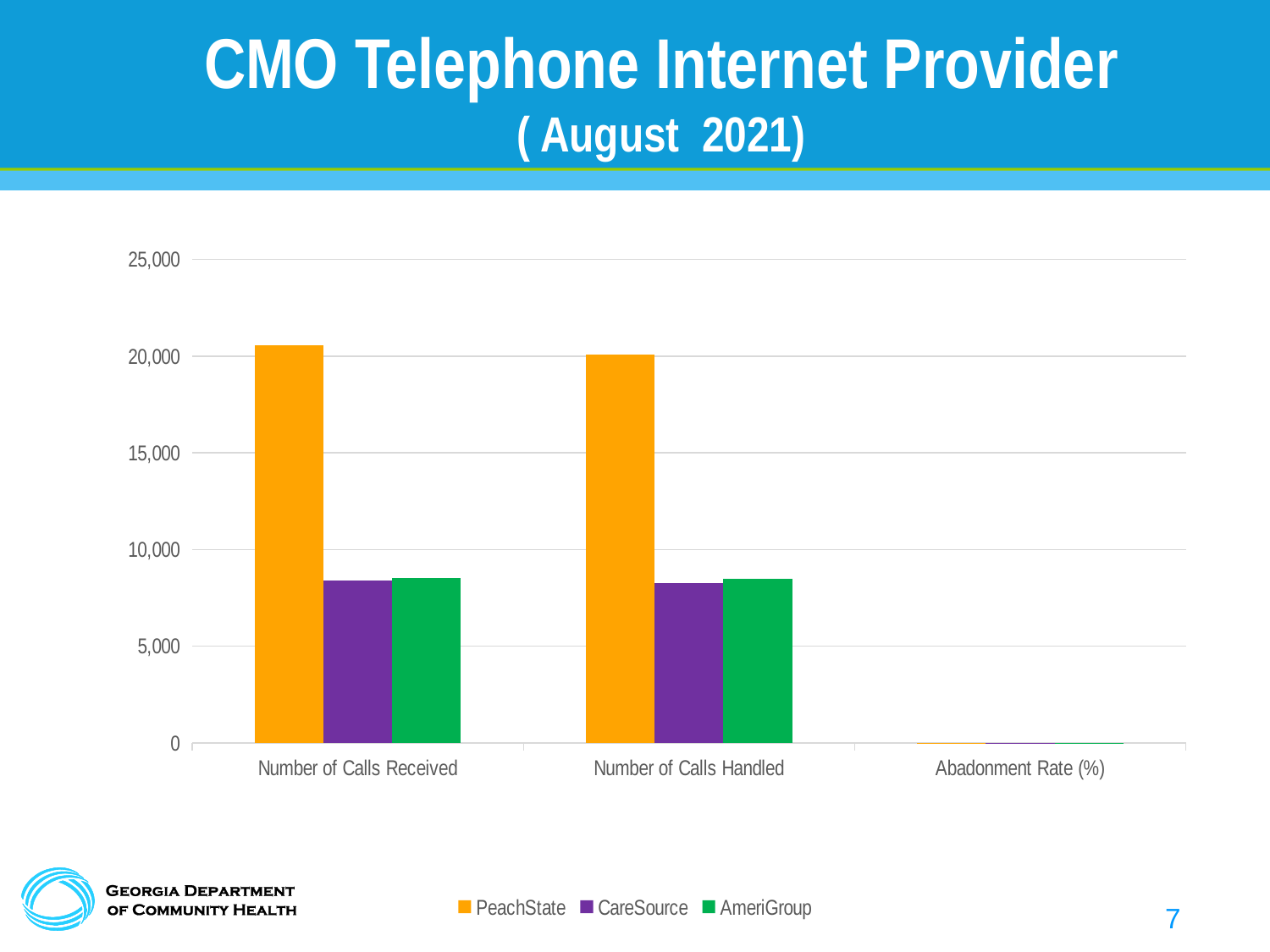
Is the AmeriGroup value for Number of Calls Handled greater or less than 10,000? less What kind of chart is shown on the slide? bar chart Which series has the highest value for Number of Calls Handled? PeachState Is the PeachState value for Number of Calls Received greater or less than 20,000? greater Which category has the lowest values for all three series? Abadonment Rate (%) Which series has the highest value for Number of Calls Received? PeachState Which is larger for Number of Calls Handled: PeachState or CareSource? PeachState How many series does the legend list? 3 Which colour represents CareSource in the legend? purple What is the title of the chart on the slide? CMO Telephone Internet Provider ( August 2021) Is the CareSource value for Number of Calls Received greater or less than 10,000? less How many categories are shown on the x axis? 3